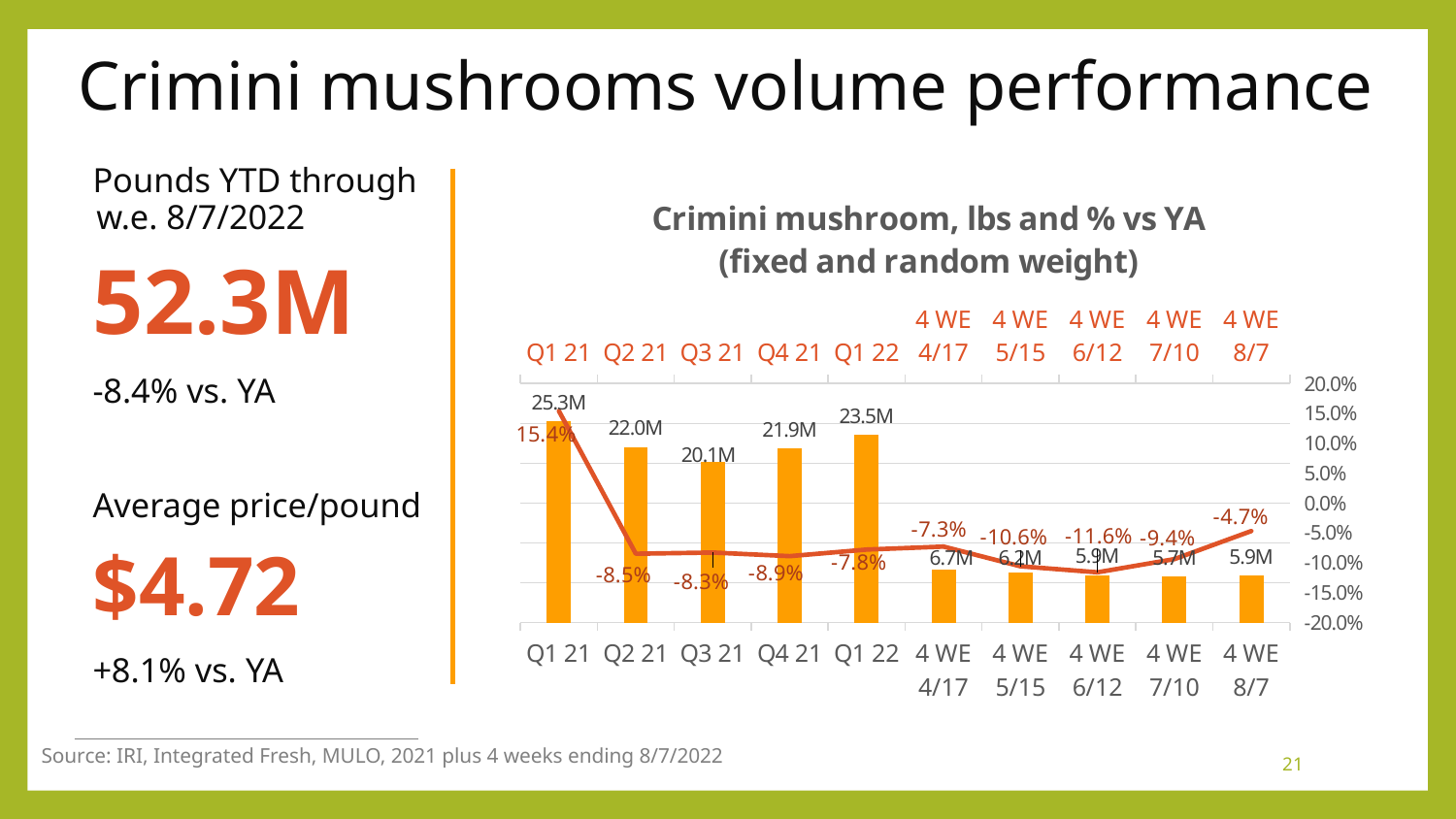
Which has the larger pounds value, Q1 22 or Q3 21? Q1 22 What kind of chart is this? Bar chart with a line Do the pounds values rise or fall from Q1 21 to Q3 21? Fall What is the % vs YA value for Q1 21? 15.4% Which period has the highest pounds value? Q1 21 What is the % vs YA value for 4 WE 8/7? -4.7% What is the difference in pounds between Q1 22 and Q4 21? 1.6M What is the title of the chart? Crimini mushroom, lbs and % vs YA (fixed and random weight) What is the pounds value for Q1 21? 25.3M Which period has the lowest % vs YA value? 4 WE 6/12 What is the pounds value for 4 WE 7/10? 5.7M How many periods are shown on the x axis? 10